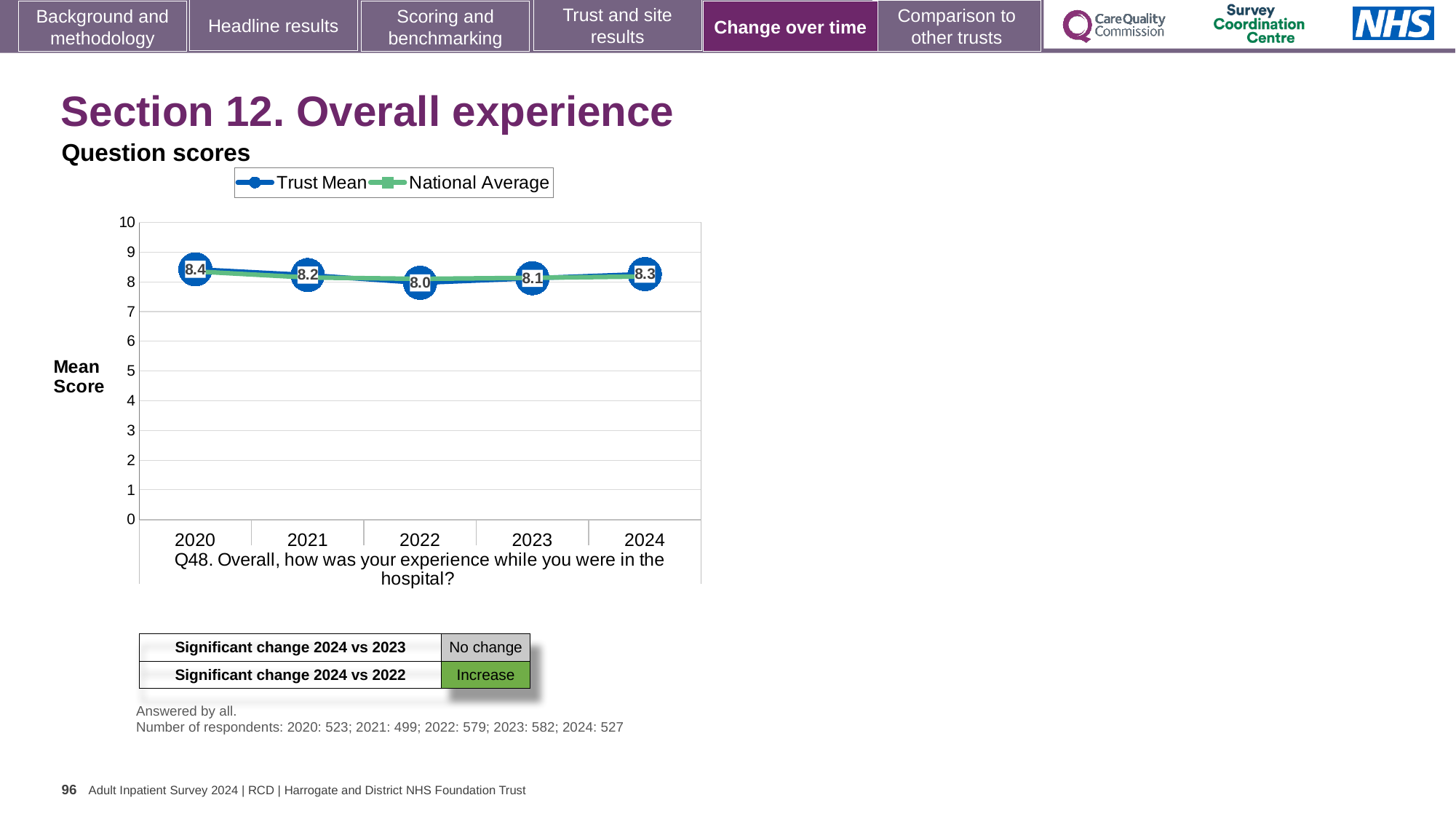
What is the difference between the Trust Mean scores for 2020 and 2022? 0.4 What is the Trust Mean score for 2022? 8.0 How many series does the legend list? 2 Is the National Average value for 2020 greater or less than 5? greater What kind of chart is shown on the slide? Line chart In which year is the Trust Mean score lowest? 2022 What is the Trust Mean score for 2024? 8.3 Which year has the larger Trust Mean score, 2021 or 2024? 2024 Does the Trust Mean score rise or fall from 2022 to 2024? Rise In which year is the Trust Mean score highest? 2020 What is the Trust Mean score for 2020? 8.4 How many years are plotted on the x axis? 5